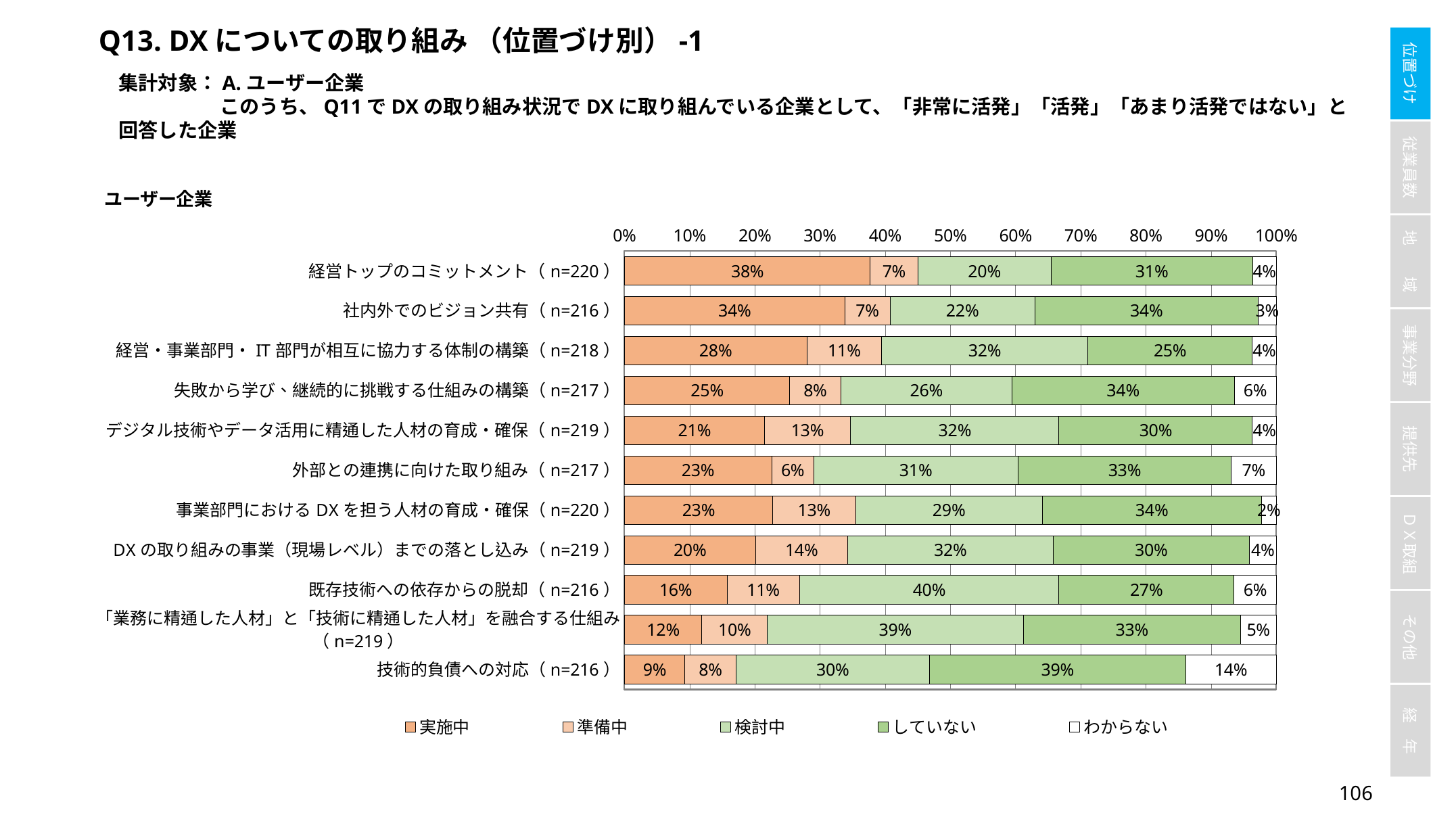
What is the difference in 実施中 between 経営トップのコミットメント and 技術的負債への対応? 29 percentage points How many series does the legend list? 5 Which is larger: the 準備中 value for DXの取り組みの事業（現場レベル）までの落とし込み or for 外部との連携に向けた取り組み? DXの取り組みの事業（現場レベル）までの落とし込み Which category has the highest していない value? 技術的負債への対応 What type of chart is shown on the slide? Stacked bar chart How many categories (items) are plotted in the chart? 11 Which category has the highest 実施中 value? 経営トップのコミットメント What is the わからない value for 技術的負債への対応? 14% What is the 実施中 value for 経営トップのコミットメント? 38% What is the 検討中 value for 既存技術への依存からの脱却? 40% Which category has the lowest 実施中 value? 技術的負債への対応 What is the sample size (n) shown for 社内外でのビジョン共有? n=216